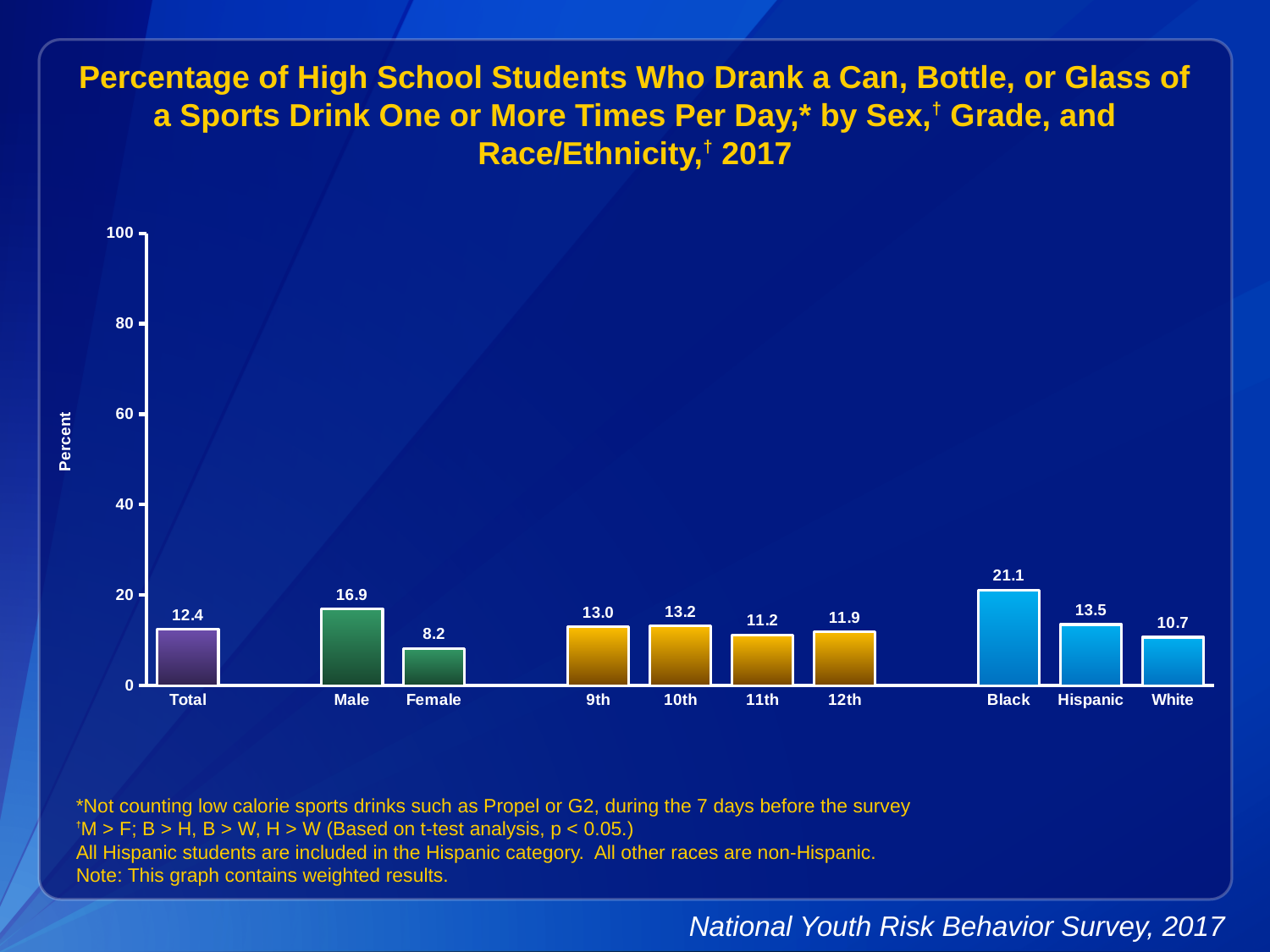
How many categories are shown on the x axis? 10 What is the difference between the values for Male and Female? 8.7 What is the difference between the values for Black and White? 10.4 What is the value for Female? 8.2 What is the value for Hispanic? 13.5 What is the value for Total? 12.4 Which category has the highest value? Black Which is larger, the value for 9th grade or 12th grade? 9th What is the value for 11th grade? 11.2 Which category has the lowest value? Female Is the value for Black greater or less than 20? greater What kind of chart is this? bar chart